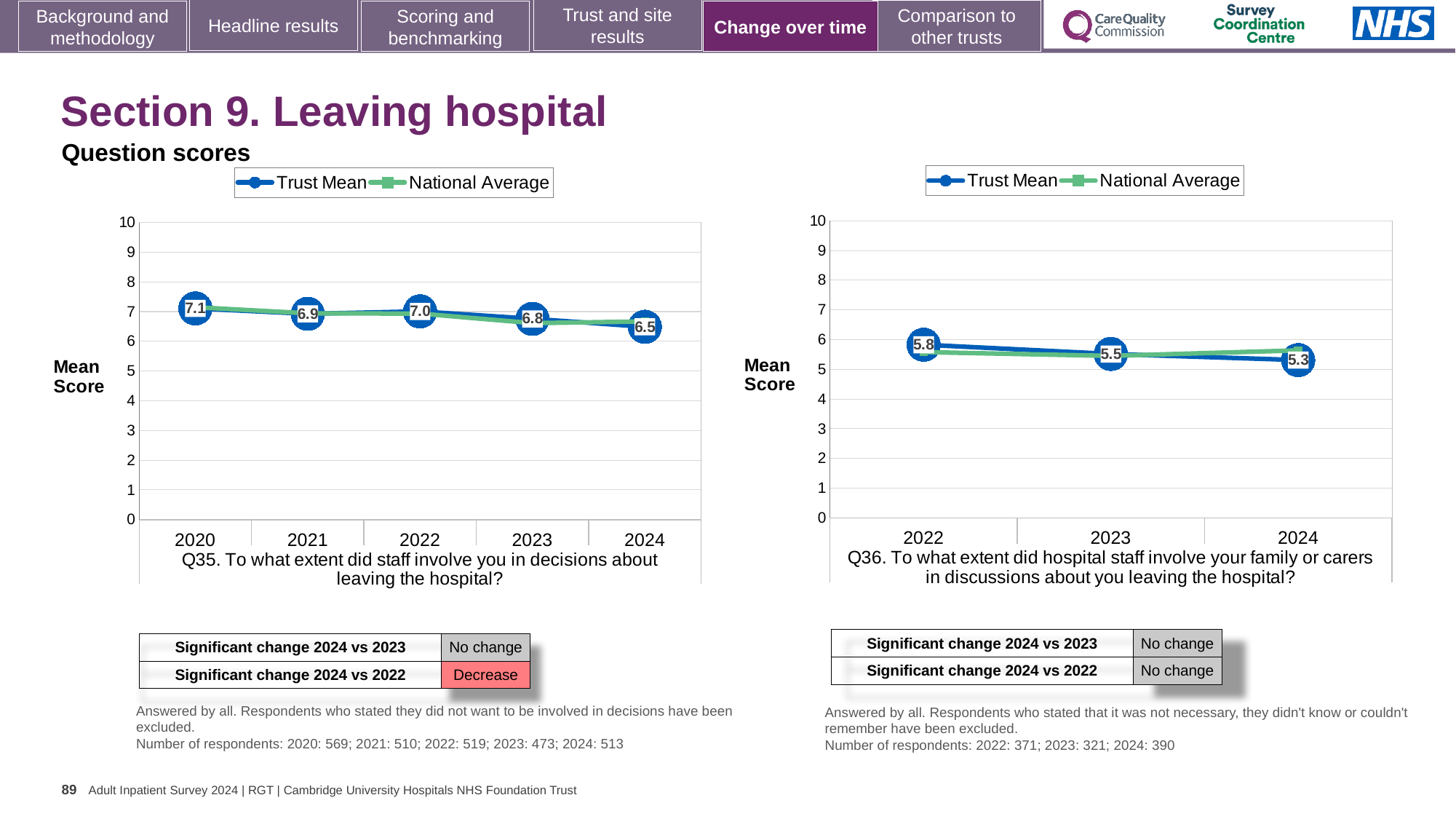
In the Q35 chart (left), how many years are plotted on the x axis? 5 In the Q35 chart (left), which year has the lowest Trust Mean score? 2024 In the Q36 chart (right), is the Trust Mean score for 2023 greater or less than 6? less In the Q35 chart (left), what is the difference between the Trust Mean scores for 2020 and 2024? 0.6 In the Q36 chart (right), does the Trust Mean rise or fall from 2022 to 2024? fall How many series does the legend of the Q36 chart (right) list? 2 In the Q35 chart (left), which year has the highest Trust Mean score? 2020 In the Q36 chart (right), what is the Trust Mean score for 2022? 5.8 In the Q36 chart (right), what is the Trust Mean score for 2024? 5.3 In the Q35 chart (left), what is the Trust Mean score for 2024? 6.5 In the Q35 chart (left), what is the Trust Mean score for 2020? 7.1 What kind of chart is the Q35 chart (left)? line chart